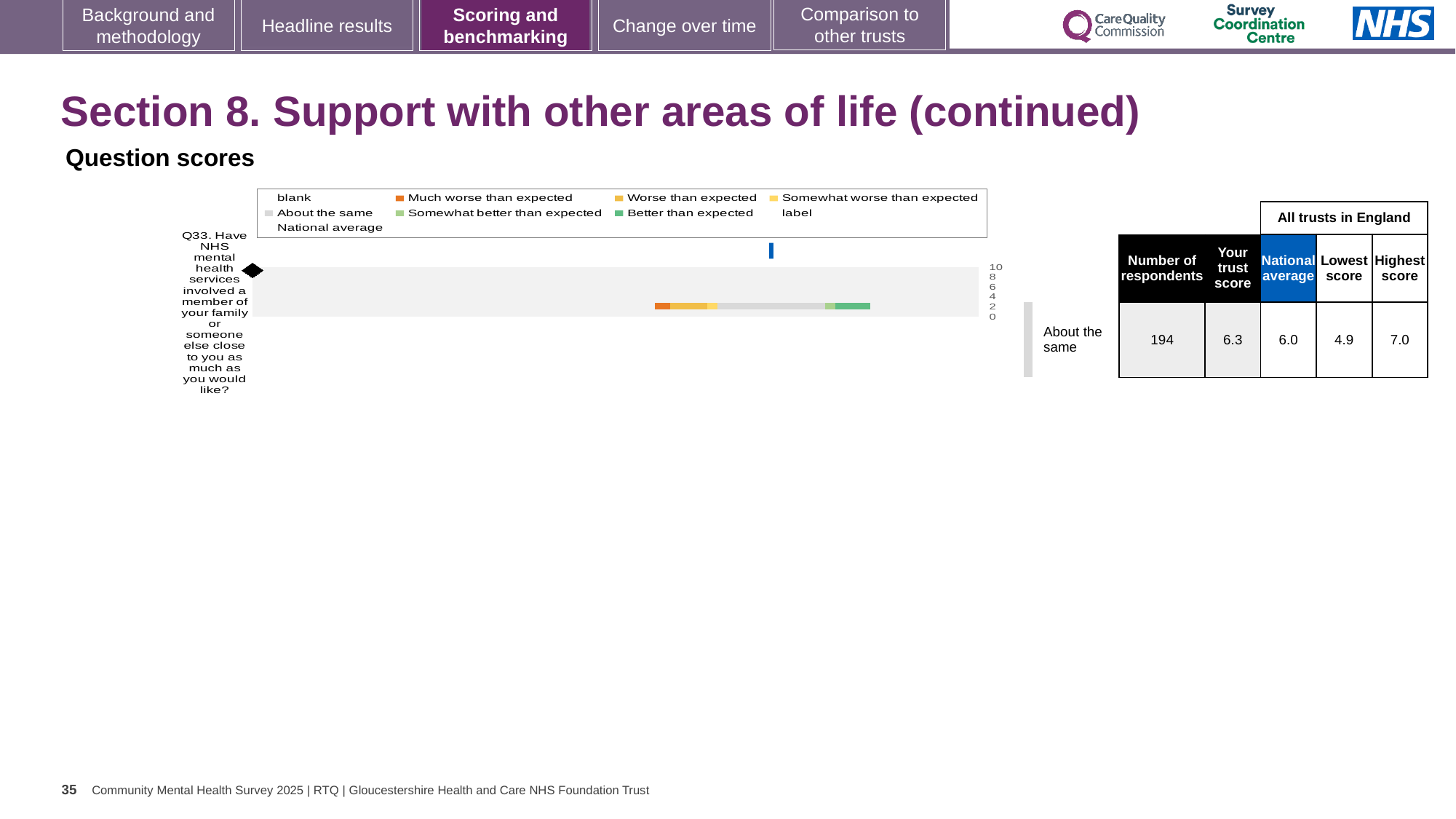
What is the highest score among all trusts in England for Q33? 7.0 What kind of chart is shown on the slide? bar chart How many survey questions are plotted in the chart? 1 What is the national average score for Q33? 6.0 How many respondents answered Q33? 194 What colour does the legend use for 'Much worse than expected'? orange What is the difference between the highest score and the lowest score for Q33? 2.1 What is the trust's score for Q33? 6.3 How many entries does the chart legend list? 9 Which question number is plotted in the chart? Q33 What is the lowest score among all trusts in England for Q33? 4.9 Which is larger for Q33, the trust's score or the national average? the trust's score